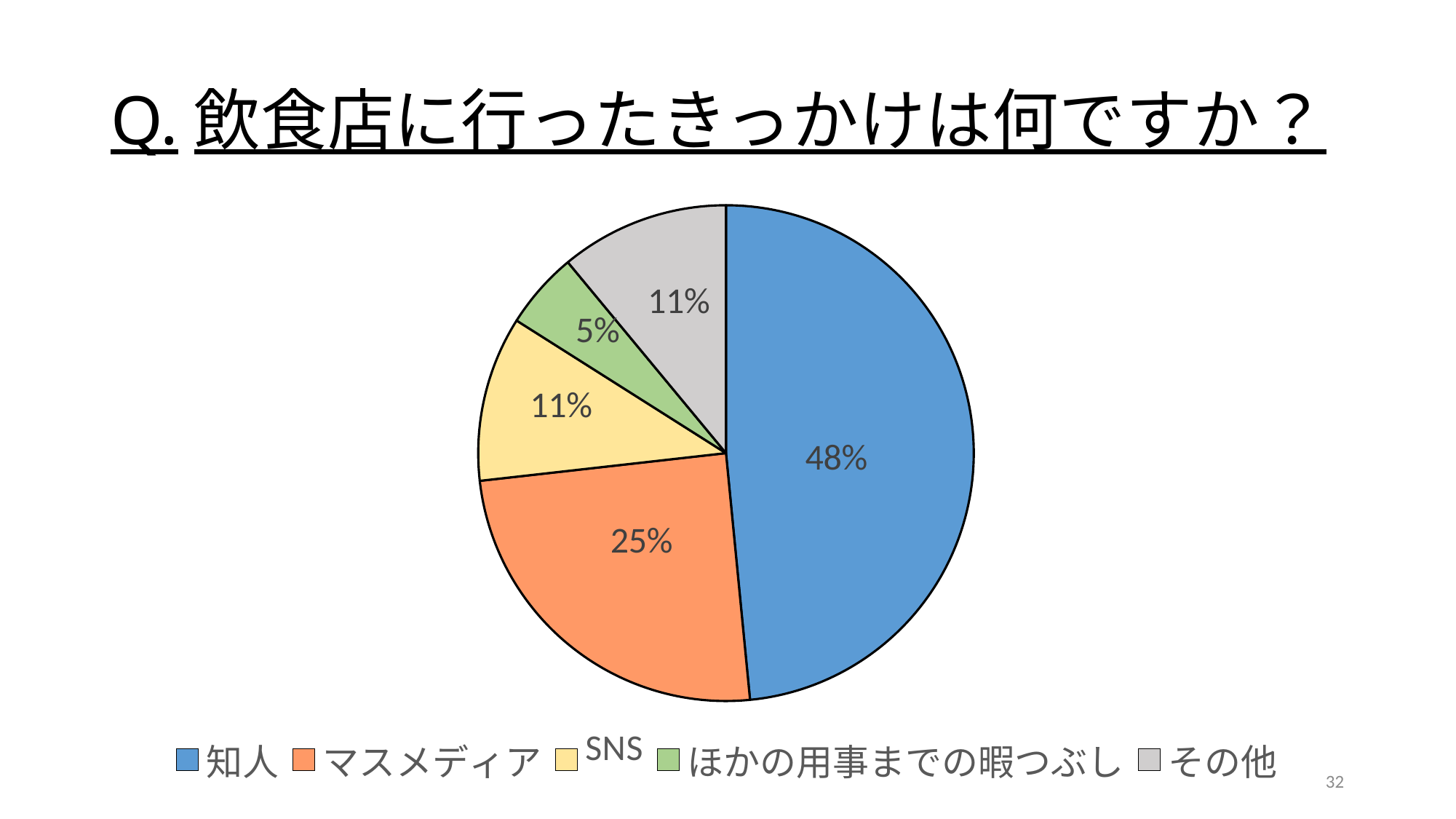
Which colour represents SNS in the legend? yellow What is the difference in percentage points between 知人 and マスメディア? 23 What type of chart is shown on the slide? pie chart What is the value of the SNS slice? 11% What percentage is shown for マスメディア? 25% Which is larger, the share for マスメディア or the share for その他? マスメディア Which category has the largest share of the pie? 知人 Which category has the smallest share of the pie? ほかの用事までの暇つぶし What share of the pie does 知人 account for? 48% How many slices does the pie chart have? 5 What percentage is shown for ほかの用事までの暇つぶし? 5% What is the title of the chart? Q. 飲食店に行ったきっかけは何ですか？